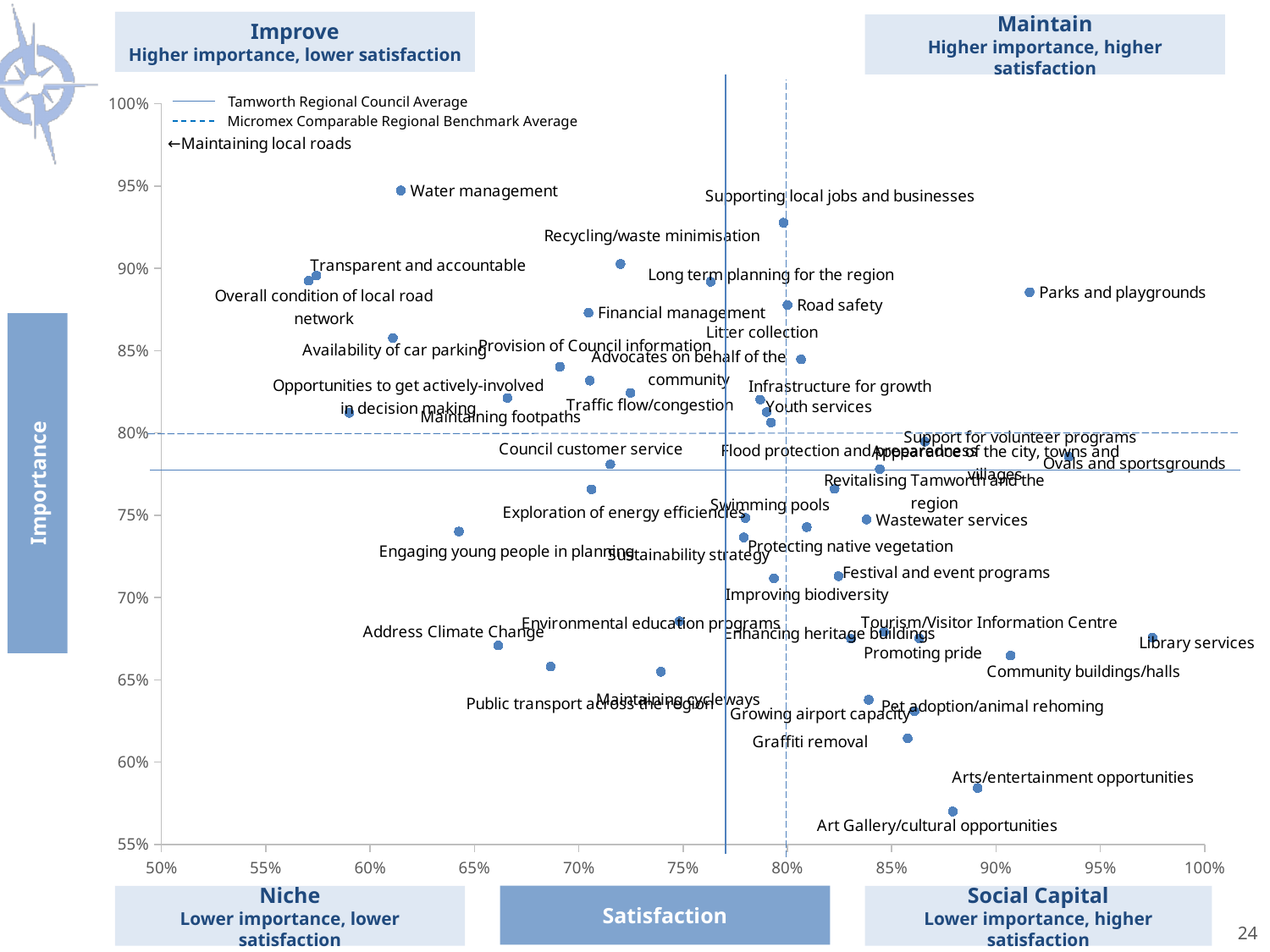
What kind of chart is shown on the slide? Scatter plot Is the importance value for Art Gallery/cultural opportunities greater or less than 60%? less Is the importance value for Parks and playgrounds greater or less than 85%? greater Which has the higher satisfaction value, Library services or Community buildings/halls? Library services Which has the higher importance value, Water management or Parks and playgrounds? Water management Which service area has the highest satisfaction score on the chart? Library services Is the importance value for Address Climate Change greater or less than 70%? less What does the dashed line on the chart represent, according to the legend? Micromex Comparable Regional Benchmark Average What is the label of the vertical (y) axis of the chart? Importance